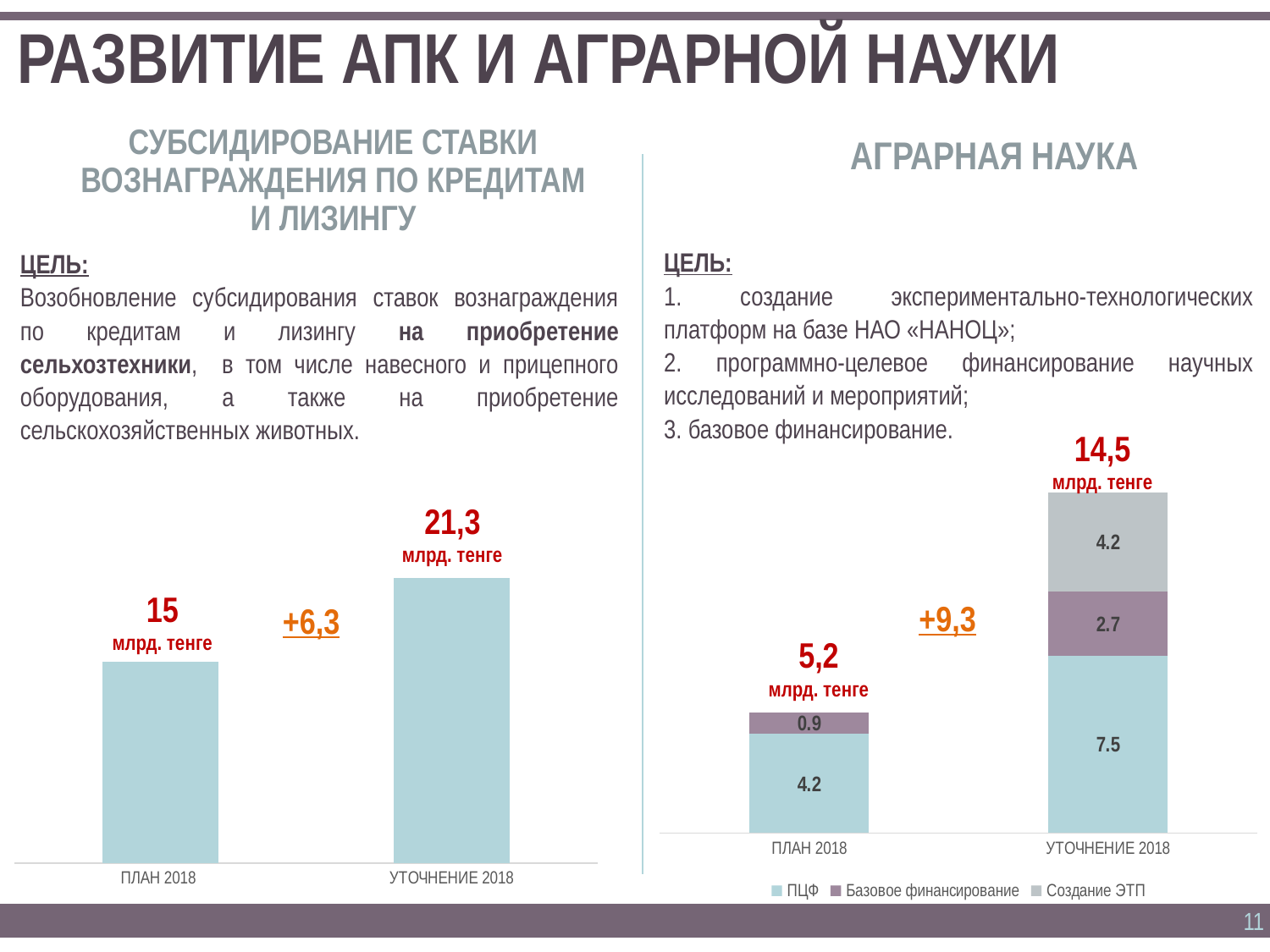
On the left chart, what is the difference between УТОЧНЕНИЕ 2018 and ПЛАН 2018? +6,3 On the right chart, what is the Базовое финансирование value for ПЛАН 2018? 0.9 On the right chart (АГРАРНАЯ НАУКА), how many series does the legend list? 3 On the right chart, what is the Создание ЭТП value for УТОЧНЕНИЕ 2018? 4.2 On the left chart (subsidising of interest rates on loans and leasing), what is the value for ПЛАН 2018? 15 млрд. тенге On the right chart, what is the total of the УТОЧНЕНИЕ 2018 stacked bar? 14,5 млрд. тенге On the left chart, what is the value for УТОЧНЕНИЕ 2018? 21,3 млрд. тенге What kind of chart is shown on the right side of the slide (АГРАРНАЯ НАУКА)? Stacked bar chart On the left chart, which category has the higher value, ПЛАН 2018 or УТОЧНЕНИЕ 2018? УТОЧНЕНИЕ 2018 On the right chart, what is the total of the ПЛАН 2018 stacked bar? 5,2 млрд. тенге On the left chart, how many bars are plotted? 2 On the right chart, what is the ПЦФ value for УТОЧНЕНИЕ 2018? 7.5